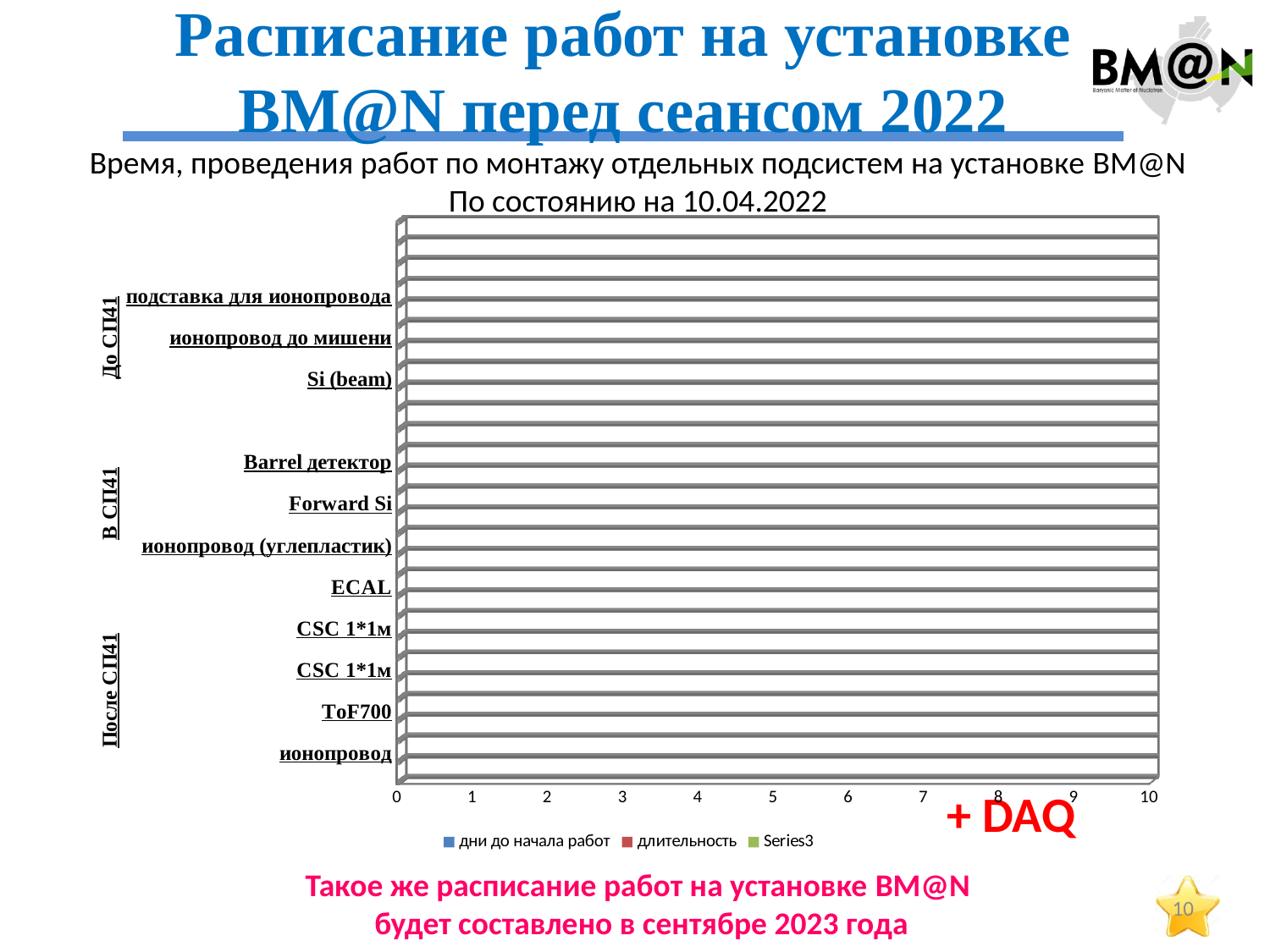
What kind of chart is shown on the slide? bar chart Is the total bar length for ToF700 greater or less than 5? greater How many series does the chart legend list? 3 How many group labels (such as До СП41) are shown along the vertical axis of the chart? 3 Is the total bar length for ECAL greater or less than 5? greater What is the highest value shown on the chart's horizontal axis? 10 What is the first series named in the chart legend? дни до начала работ